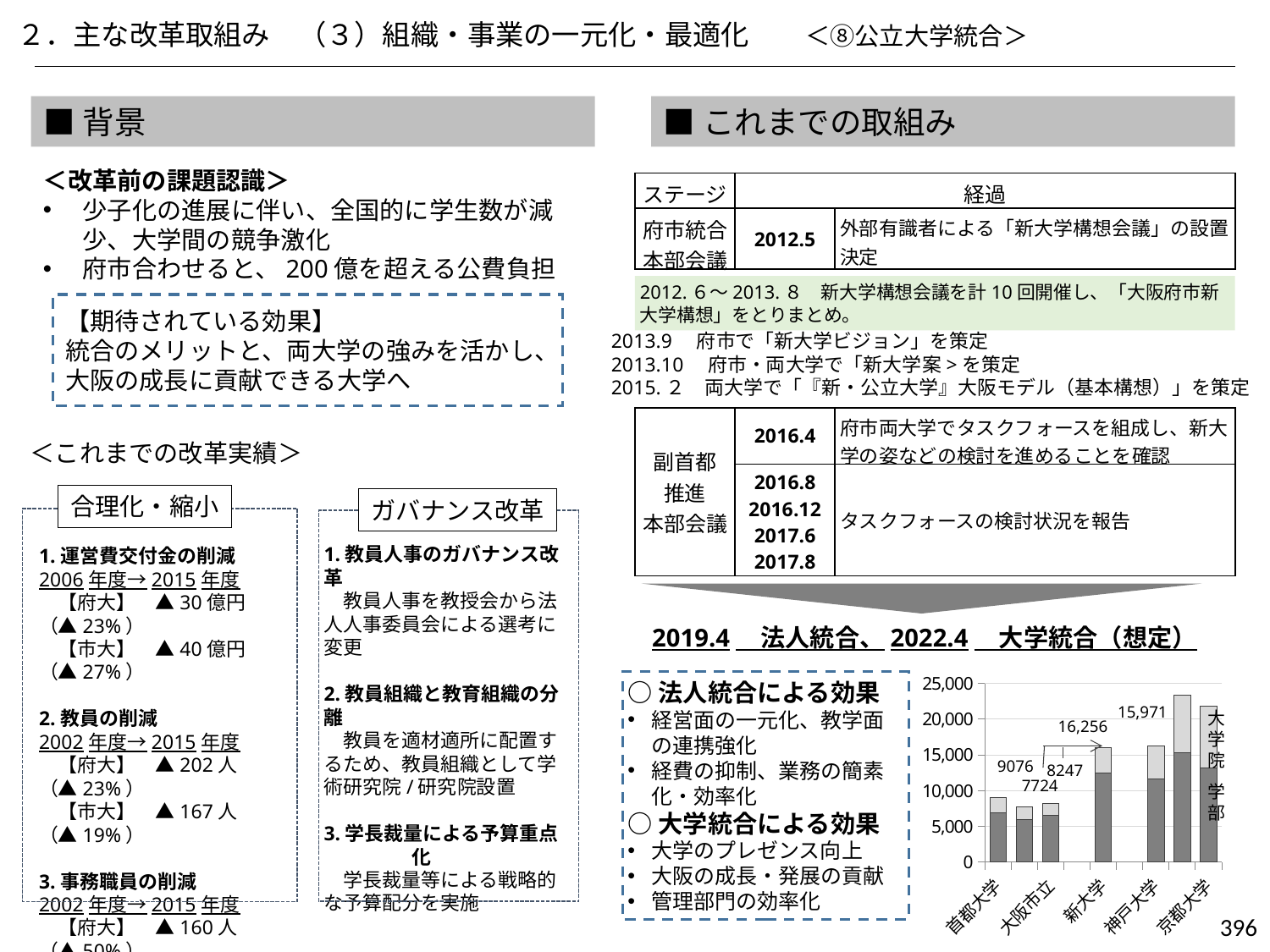
How many universities are labelled on the x axis of the bar chart? 5 Is the total for 京都大学 greater or less than 20,000? greater Which bar is taller, 京都大学 or 首都大学? 京都大学 Is the total for 首都大学 greater or less than 10,000? less Is the total for 神戸大学 greater or less than 10,000? greater What is the highest value shown on the y axis of the bar chart? 25,000 What kind of chart is shown at the bottom right of the slide? bar chart What is the value labelled for 首都大学 in the bar chart? 9076